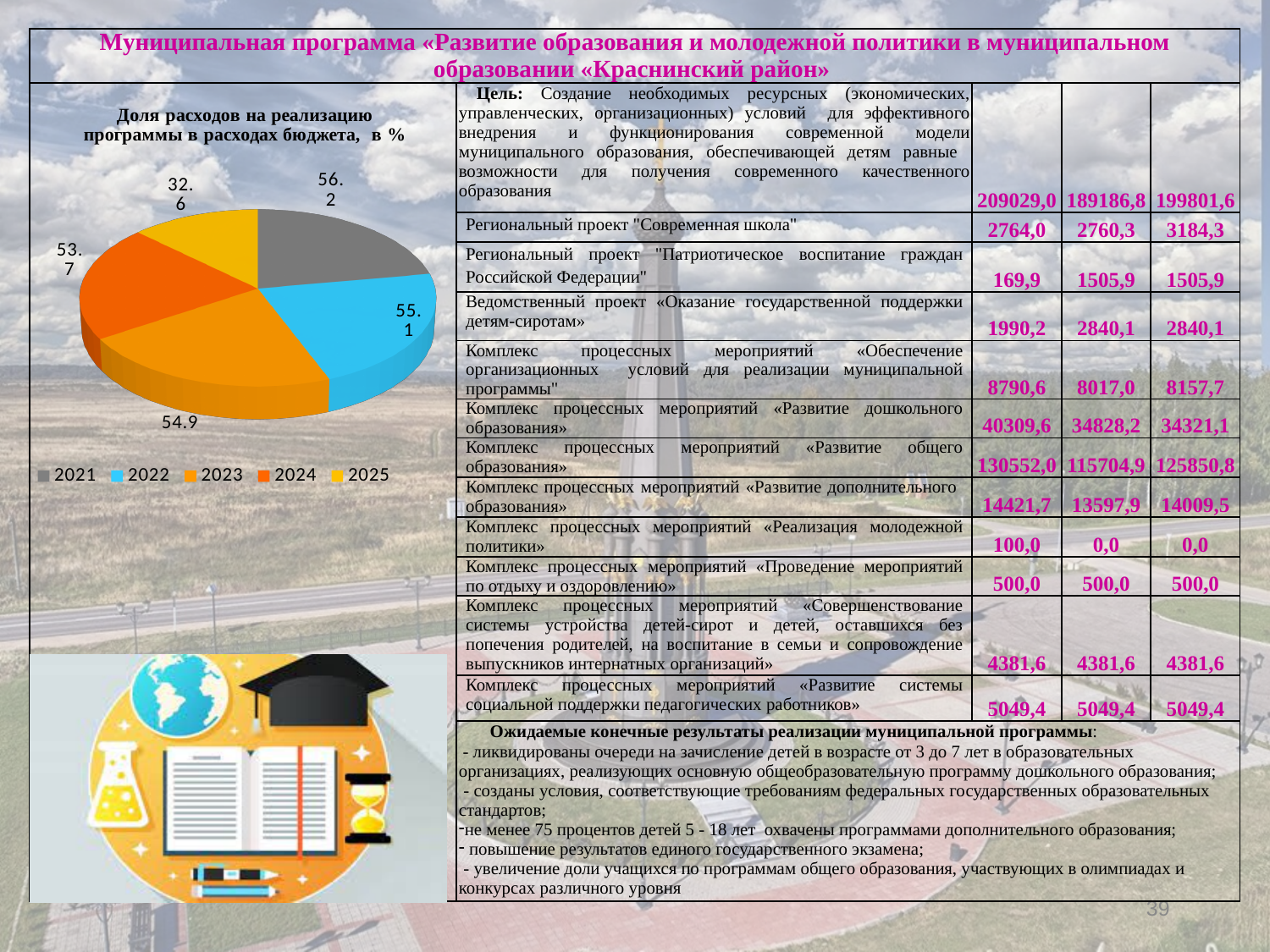
Which year has the smallest value in the pie chart? 2025 In the pie chart, what is the value for 2023? 54.9 What kind of chart is shown on the left of the slide? Pie chart How many years (slices) does the pie chart show? 5 In the pie chart, what is the value for 2025? 32.6 Which year has the largest value in the pie chart? 2021 What is the difference between the values for 2021 and 2025 in the pie chart? 23.6 In the pie chart, what is the value for 2021? 56.2 In the pie chart, what is the value for 2024? 53.7 What is the title of the pie chart? Доля расходов на реализацию программы в расходах бюджета, в % Which colour represents 2025 in the pie chart legend? Yellow In the pie chart, what is the value for 2022? 55.1